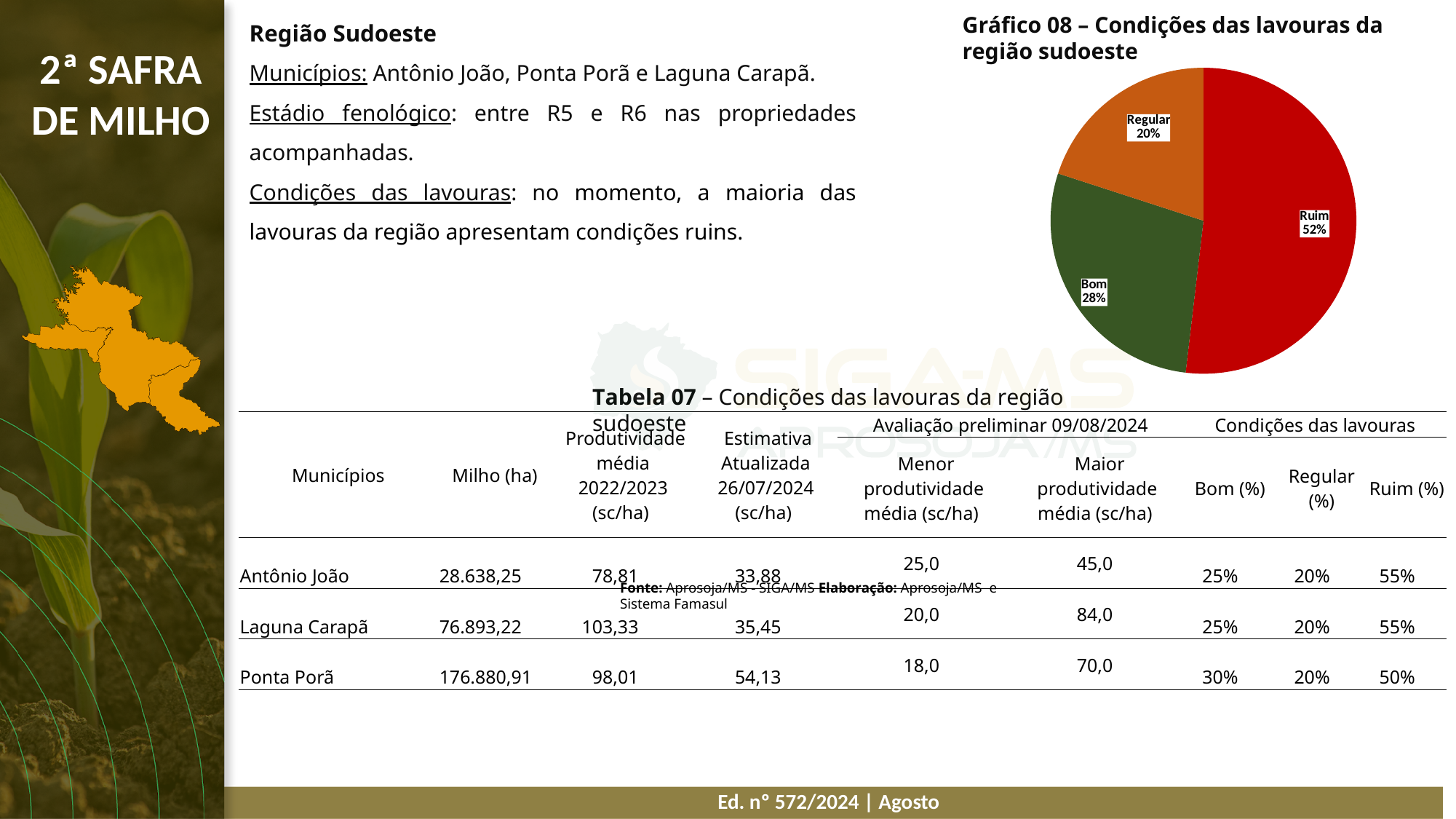
In Gráfico 08, which slice is larger: 'Bom' or 'Regular'? Bom What is the title of the pie chart on the slide? Gráfico 08 – Condições das lavouras da região sudoeste In Gráfico 08, what share of the crops is in the 'Regular' condition? 20% In Gráfico 08, what share of the crops is in the 'Ruim' condition? 52% In Gráfico 08, what is the difference in percentage points between the 'Bom' and 'Regular' slices? 8 How many slices does the pie chart in Gráfico 08 have? 3 Which category has the largest slice in Gráfico 08? Ruim In Gráfico 08, what share of the crops is in the 'Bom' condition? 28% In Gráfico 08, what colour is the 'Ruim' slice? red Which category has the smallest slice in Gráfico 08? Regular In Gráfico 08, what is the difference in percentage points between the 'Ruim' and 'Bom' slices? 24 What kind of chart is Gráfico 08? pie chart